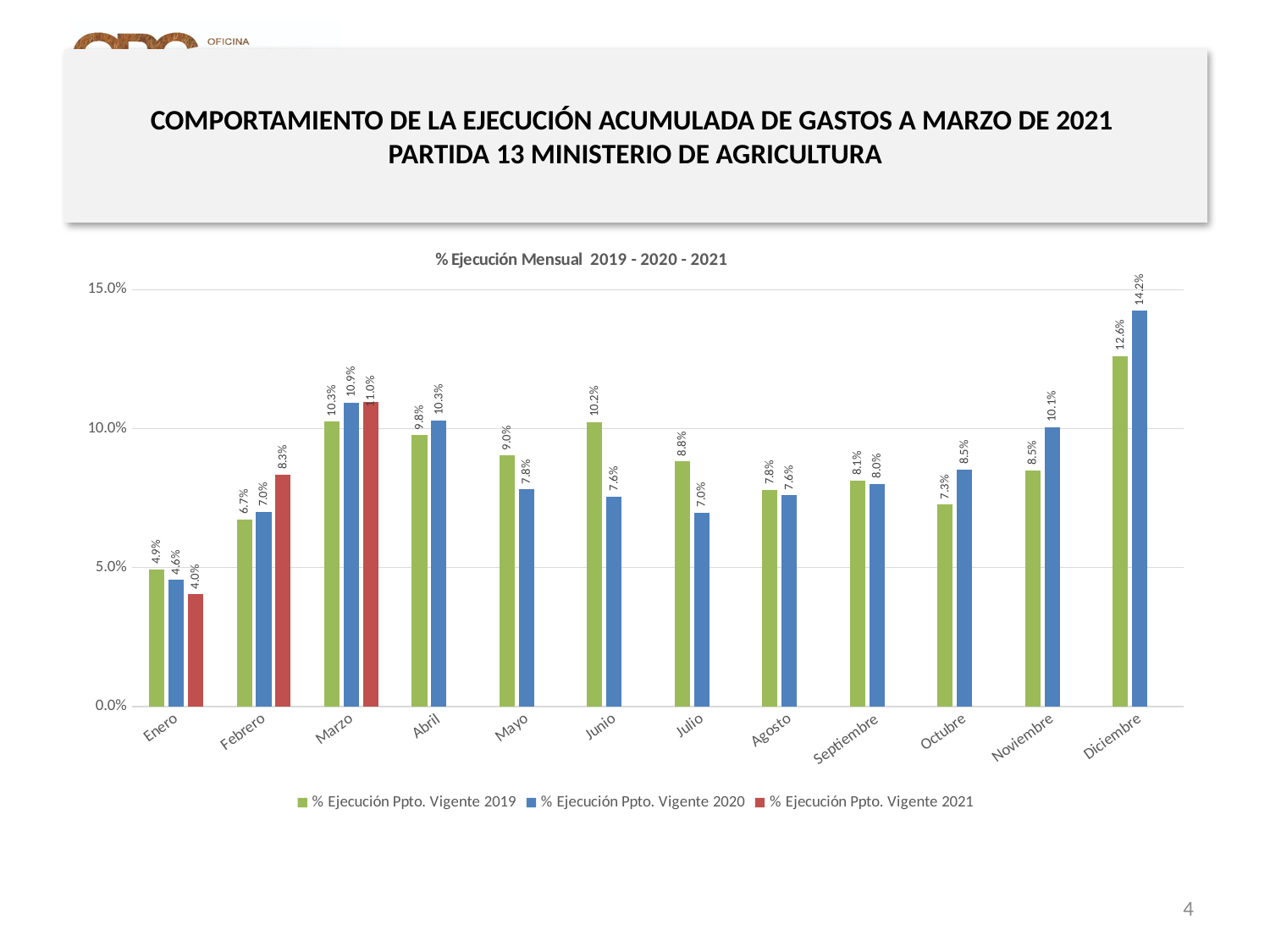
What is the value for % Ejecución Ppto. Vigente 2021 in Marzo? 11.0% Is the value for % Ejecución Ppto. Vigente 2019 in Mayo greater or less than 10.0%? less What is the difference between the 2020 and 2019 values in Diciembre? 1.6% How many months are shown on the x axis? 12 In Febrero, which series has the larger value: % Ejecución Ppto. Vigente 2019 or % Ejecución Ppto. Vigente 2021? % Ejecución Ppto. Vigente 2021 What kind of chart is shown on the slide? Bar chart How many series does the legend list? 3 Which month has the highest value for % Ejecución Ppto. Vigente 2020? Diciembre What is the value for % Ejecución Ppto. Vigente 2020 in Noviembre? 10.1% Which month has the lowest value for % Ejecución Ppto. Vigente 2019? Enero What is the title of the chart? % Ejecución Mensual 2019 - 2020 - 2021 What is the value for % Ejecución Ppto. Vigente 2019 in Junio? 10.2%